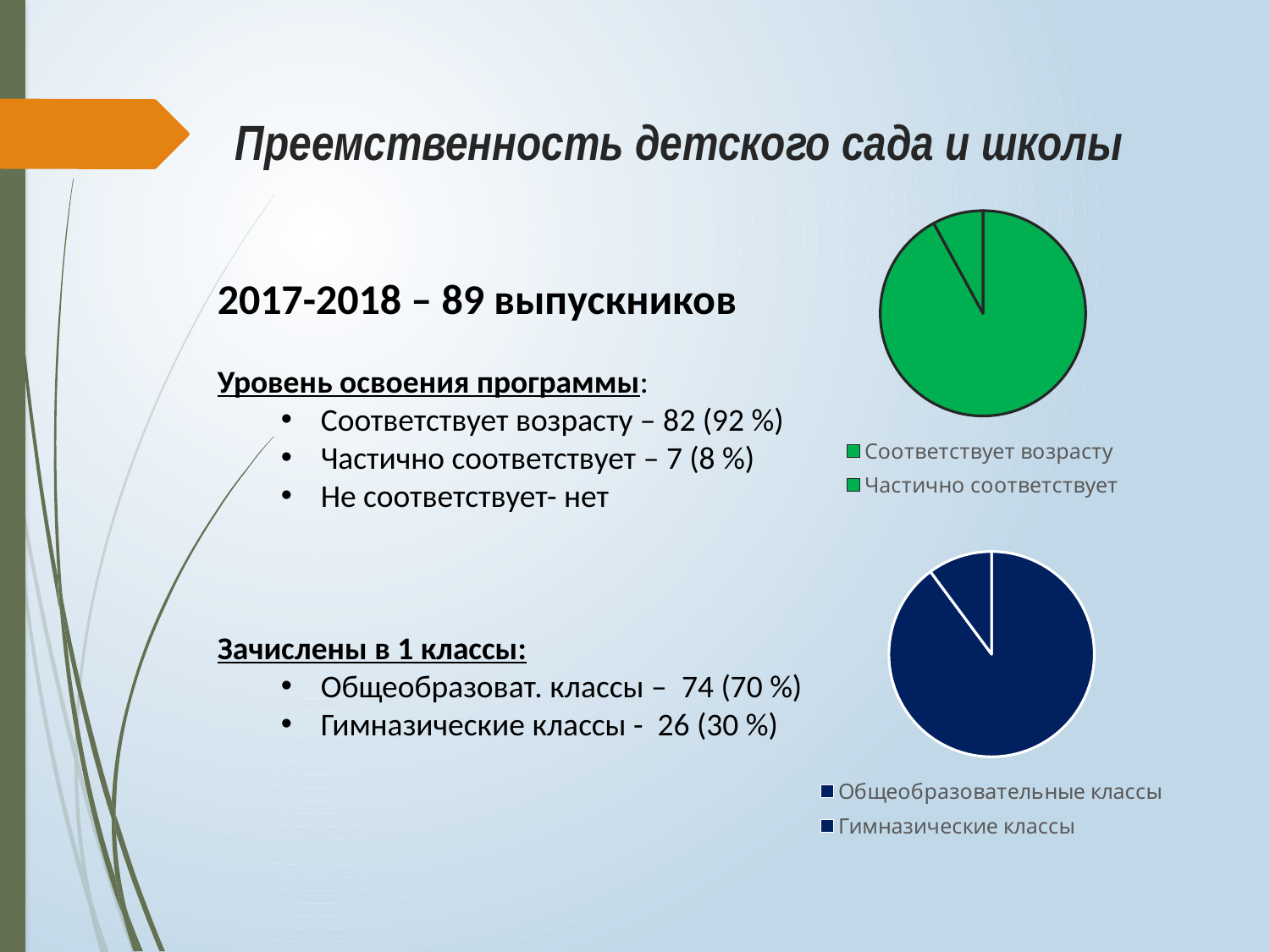
What kind of chart is the bottom chart on the right of the slide? pie chart According to the slide, what share of the top pie chart does Соответствует возрасту represent? 92 % What kind of chart is the top chart on the right of the slide? pie chart In the bottom pie chart, which category has the largest slice? Общеобразовательные классы How many entries does the legend of the top pie chart list? 2 In the top pie chart, which is larger: Соответствует возрасту or Частично соответствует? Соответствует возрасту In the top pie chart, which category has the largest slice? Соответствует возрасту What colour are the slices of the bottom pie chart? dark blue How many slices does the bottom pie chart have? 2 In the bottom pie chart, which category has the smallest slice? Гимназические классы In the top pie chart, which category has the smallest slice? Частично соответствует